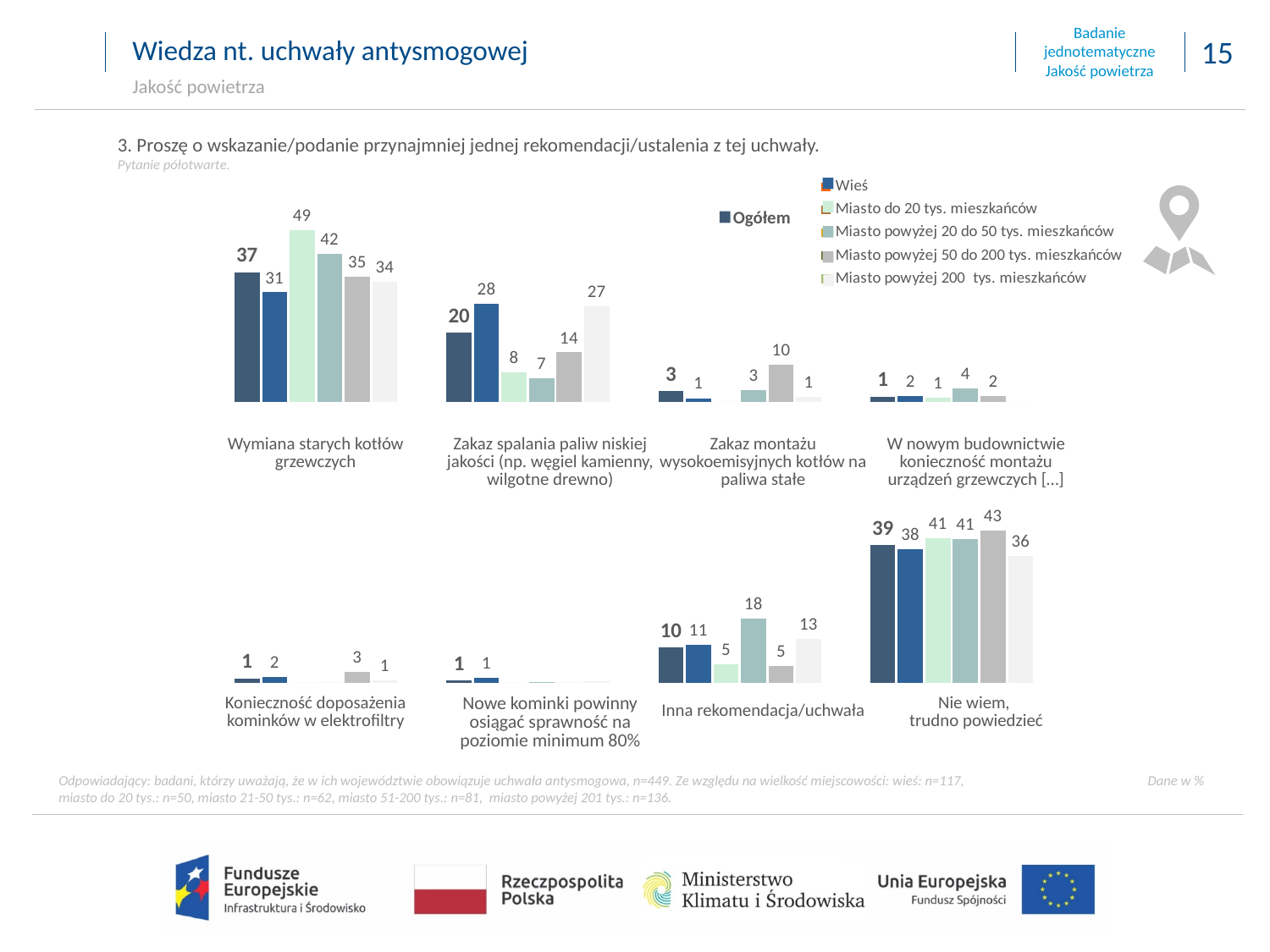
Which group has the highest value for 'Inna rekomendacja/uchwała'? Miasto powyżej 20 do 50 tys. mieszkańców What is the Wieś value for 'Zakaz spalania paliw niskiej jakości (np. węgiel kamienny, wilgotne drewno)'? 28 What is the 'Miasto powyżej 200 tys. mieszkańców' value for 'Nie wiem, trudno powiedzieć'? 36 What is the Ogółem value for 'Wymiana starych kotłów grzewczych'? 37 How many series does the legend list? 6 Which group has the highest value for 'Wymiana starych kotłów grzewczych'? Miasto do 20 tys. mieszkańców Which response category has the highest Ogółem value? Nie wiem, trudno powiedzieć What is the 'Miasto powyżej 50 do 200 tys. mieszkańców' value for 'Zakaz montażu wysokoemisyjnych kotłów na paliwa stałe'? 10 What is the difference between the 'Miasto do 20 tys. mieszkańców' and 'Wieś' values for 'Wymiana starych kotłów grzewczych'? 18 Which is larger for Ogółem: 'Wymiana starych kotłów grzewczych' or 'Nie wiem, trudno powiedzieć'? Nie wiem, trudno powiedzieć What kind of chart is shown on the slide? Bar chart How many response categories are shown on the chart? 8